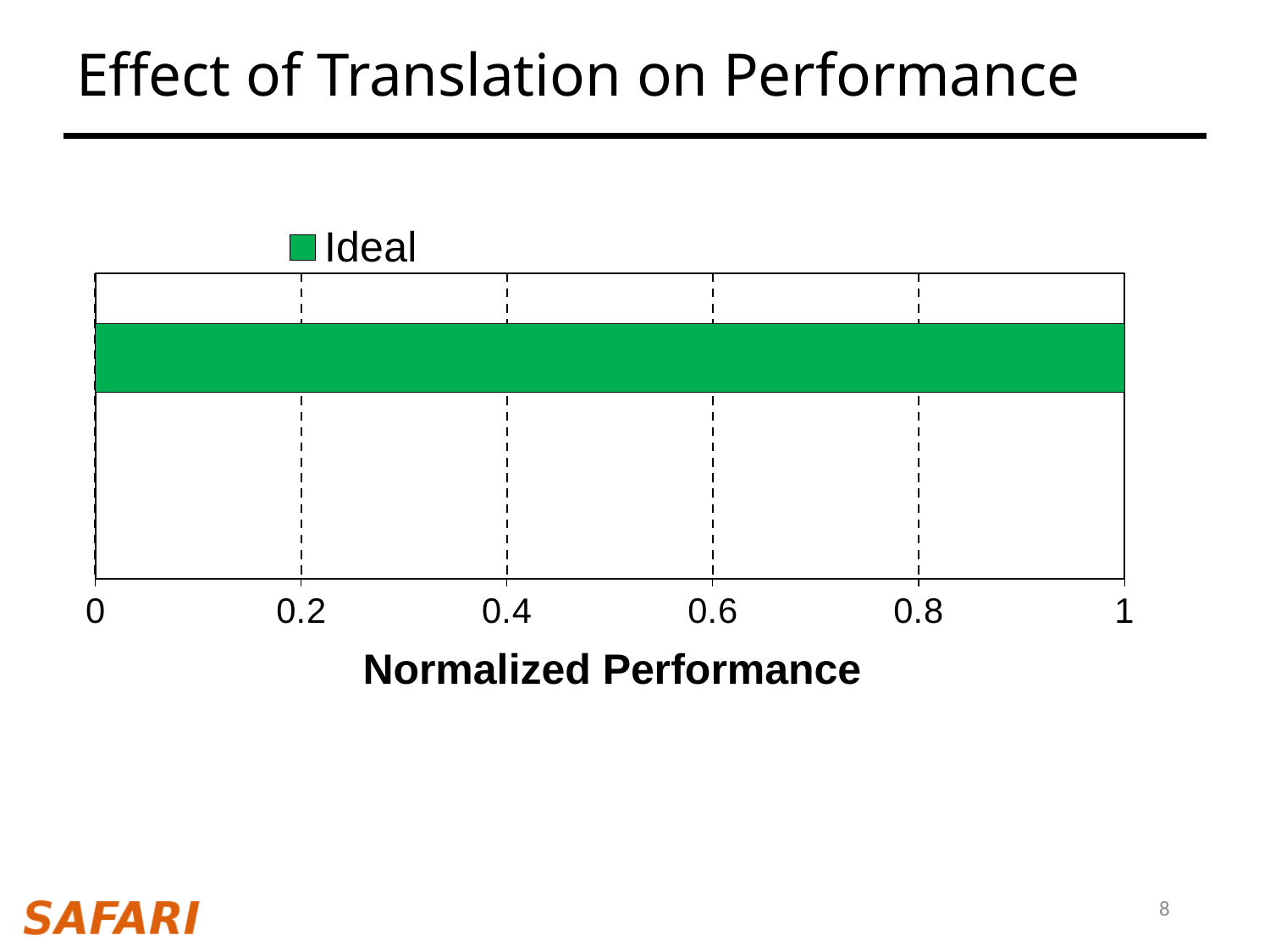
How many bars are plotted in the chart? 1 What is the name of the series shown in the legend? Ideal What is the normalized performance value for the Ideal bar? 1 What is the label of the x axis? Normalized Performance Is the value for Ideal greater or less than 0.8? greater What kind of chart is shown on the slide? bar chart Is the value for Ideal greater or less than 0.6? greater What is the lowest value shown on the x axis? 0 How many series does the legend list? 1 What is the highest value shown on the x axis? 1